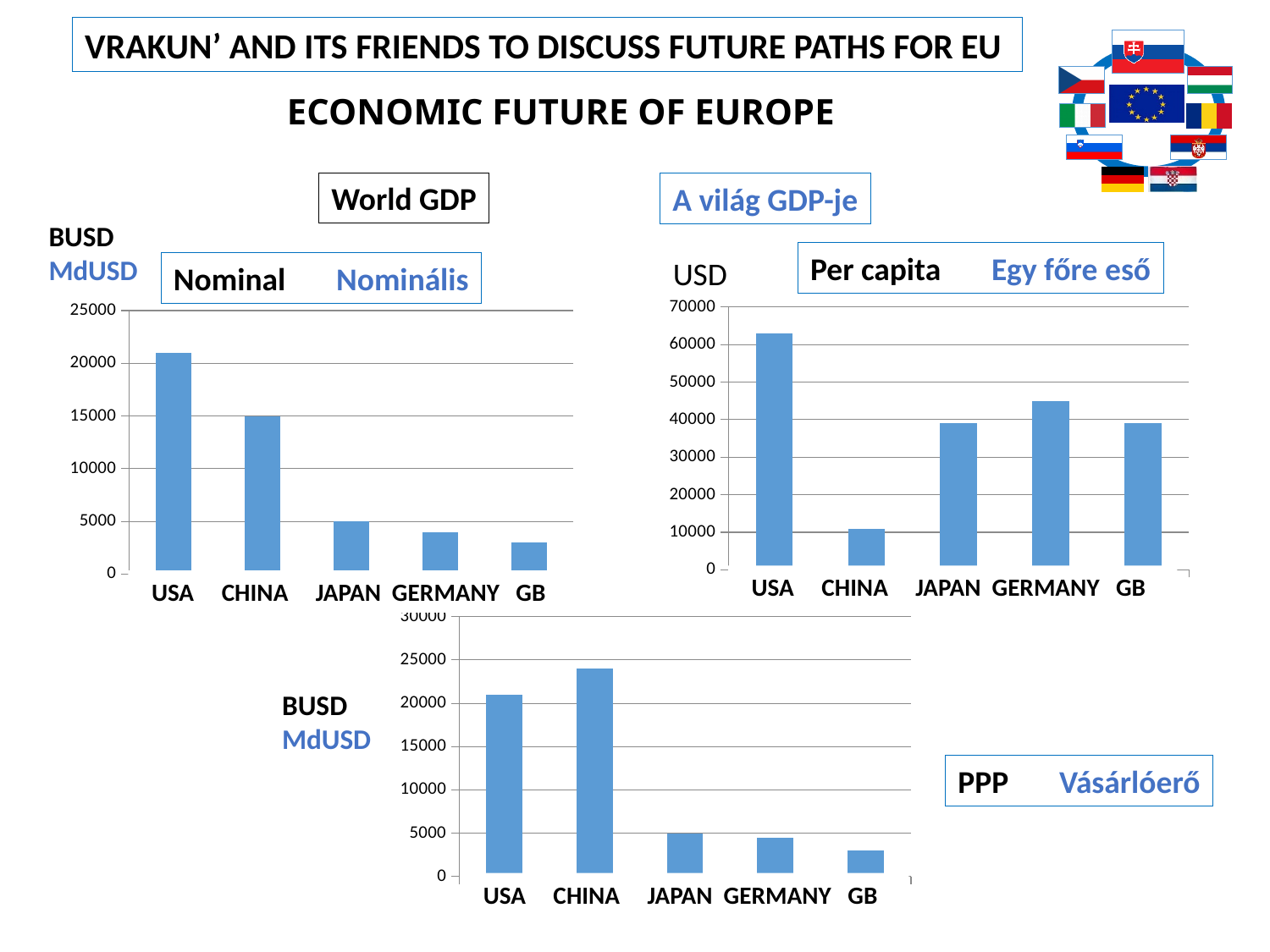
In the Per capita chart, is the value for CHINA greater or less than 20000? less In the PPP chart, which is larger, the value for USA or the value for CHINA? CHINA In the Nominal chart, which country has the highest GDP? USA In the Nominal chart, is the value for USA greater or less than 20000? greater In the Per capita chart, which country has the highest value? USA In the Per capita chart, is the value for GERMANY greater or less than 40000? greater In the PPP chart, which country has the highest GDP? CHINA In the Nominal chart, which country has the lowest GDP? GB How many countries are shown in the PPP chart? 5 In the Per capita chart, which country has the lowest value? CHINA What kind of chart is the Per capita chart? bar chart What unit is shown on the vertical axis of the Per capita chart? USD